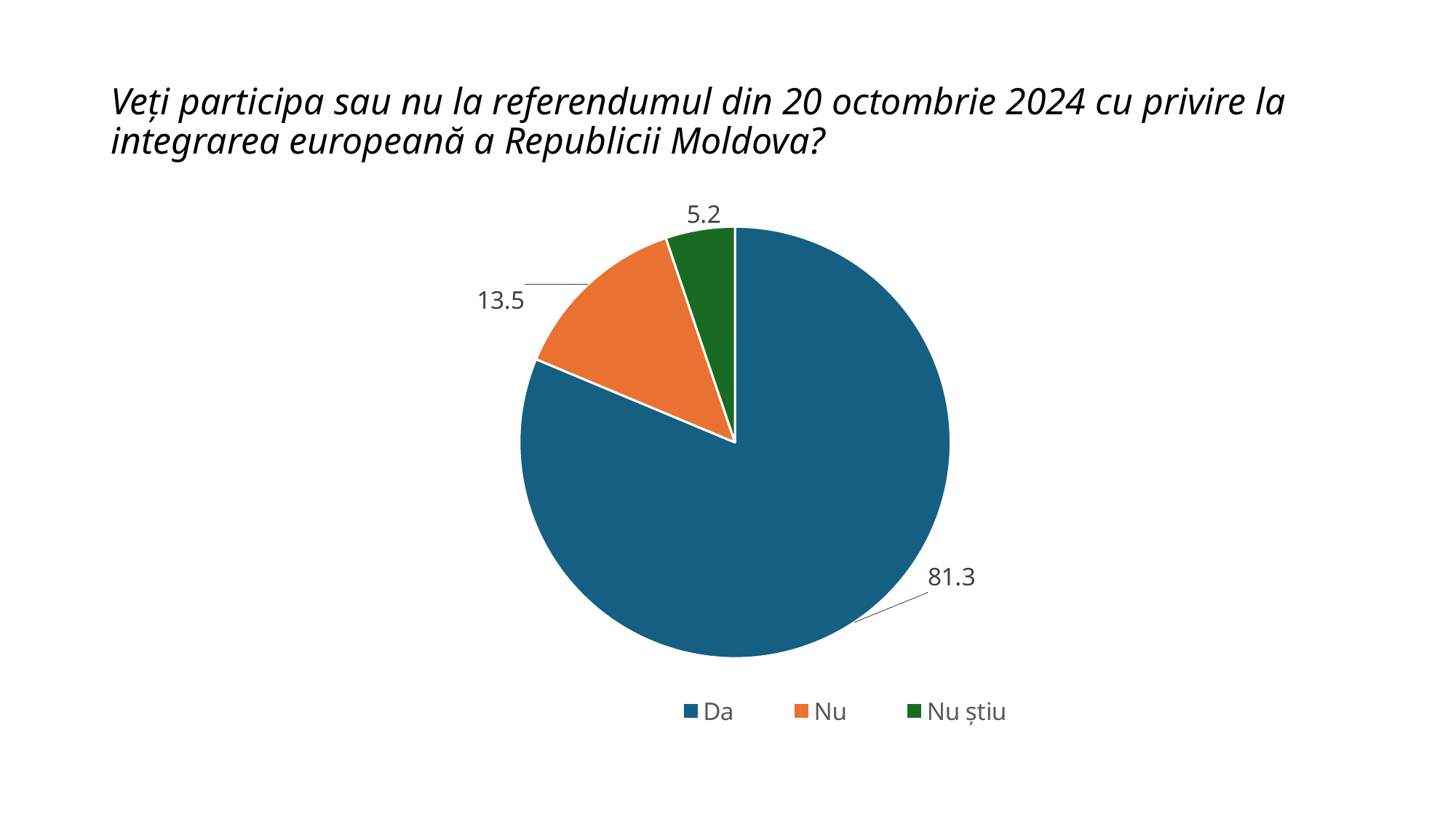
What is the value for "Nu știu"? 5.2 Which category has the largest slice? Da What is the value for "Da"? 81.3 What is the difference between the values for "Da" and "Nu"? 67.8 Which is larger, the value for "Nu" or the value for "Nu știu"? Nu What colour is the slice for "Nu"? Orange Which category has the smallest slice? Nu știu What kind of chart is shown on the slide? Pie chart How many slices does the pie chart have? 3 How many entries does the legend list? 3 What is the difference between the values for "Nu" and "Nu știu"? 8.3 What is the value for "Nu"? 13.5